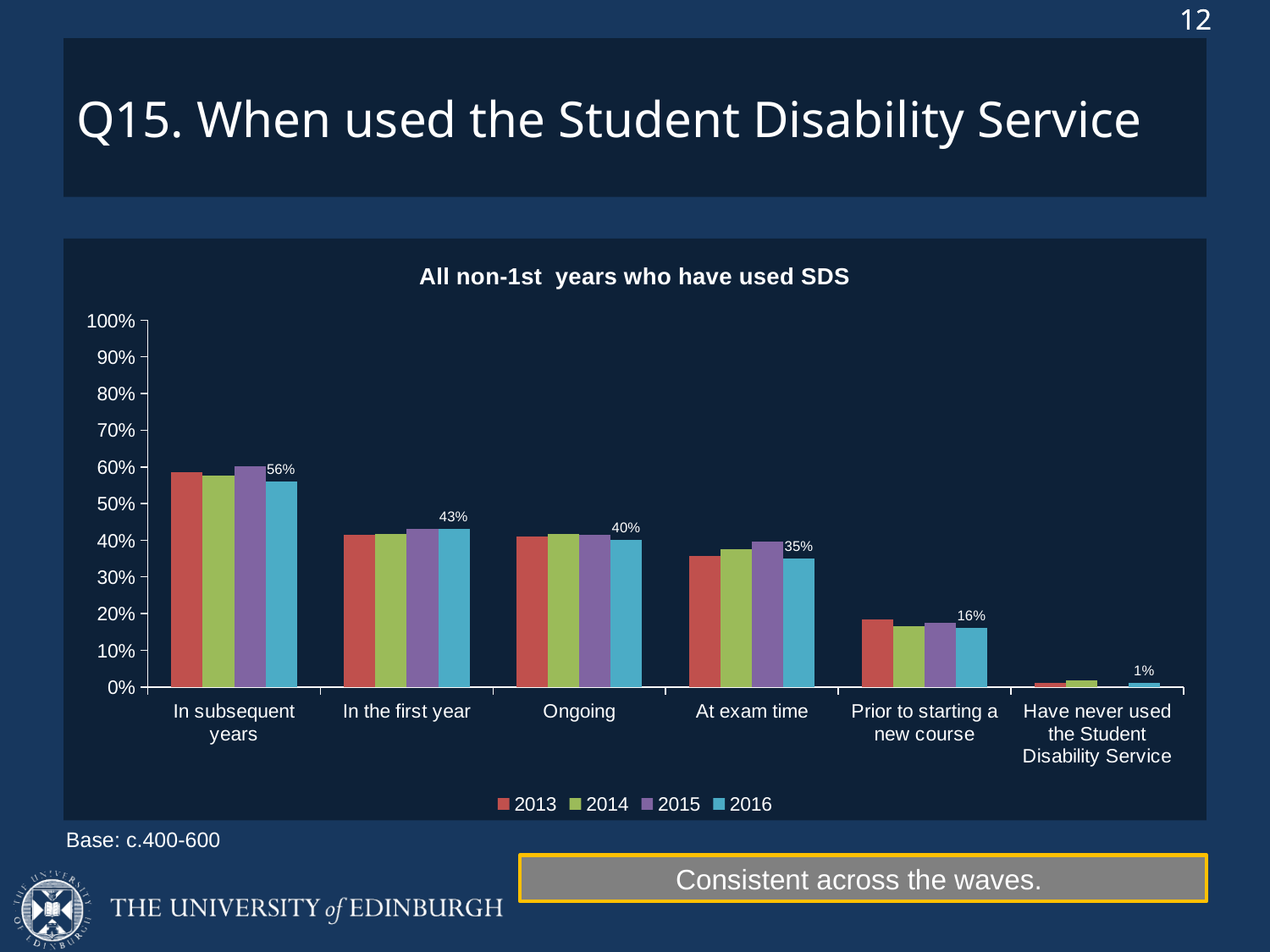
What is the difference between the 2016 values for "In the first year" and "Ongoing"? 3% What is the 2016 value for "Prior to starting a new course"? 16% Which category has the lowest 2016 value? Have never used the Student Disability Service Which category has the highest 2016 value? In subsequent years Which is larger for 2016: "Ongoing" or "At exam time"? Ongoing What kind of chart is shown on the slide? Bar chart What is the 2016 value for "At exam time"? 35% How many categories are shown on the x axis? 6 Is the 2013 value for "In subsequent years" greater or less than 50%? greater How many series does the legend list? 4 What is the 2016 value for "Have never used the Student Disability Service"? 1% What is the 2016 value for "In subsequent years"? 56%